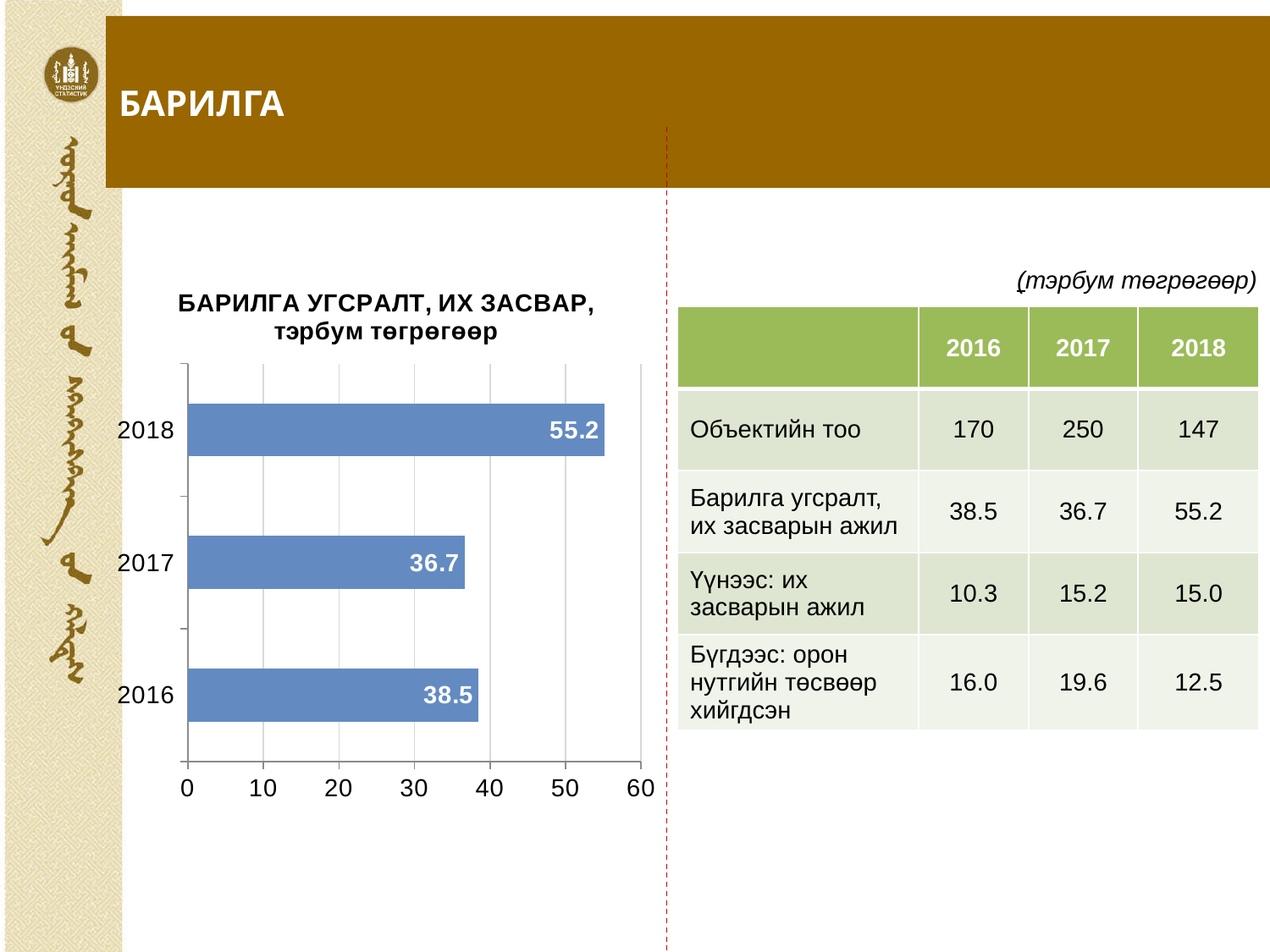
What is the title of the bar chart? БАРИЛГА УГСРАЛТ, ИХ ЗАСВАР, тэрбум төгрөгөөр What is the value for 2016 in the bar chart? 38.5 What is the value for 2017 in the bar chart? 36.7 What is the difference between the values for 2016 and 2017 in the bar chart? 1.8 What is the difference between the values for 2018 and 2016 in the bar chart? 16.7 Is the value for 2018 in the bar chart greater or less than 50? greater How many years are shown in the bar chart? 3 What is the value for 2018 in the bar chart? 55.2 Which year has the highest value in the bar chart? 2018 Which year has the lowest value in the bar chart? 2017 What kind of chart is shown on the slide? bar chart Which is larger in the bar chart, the value for 2016 or the value for 2017? 2016